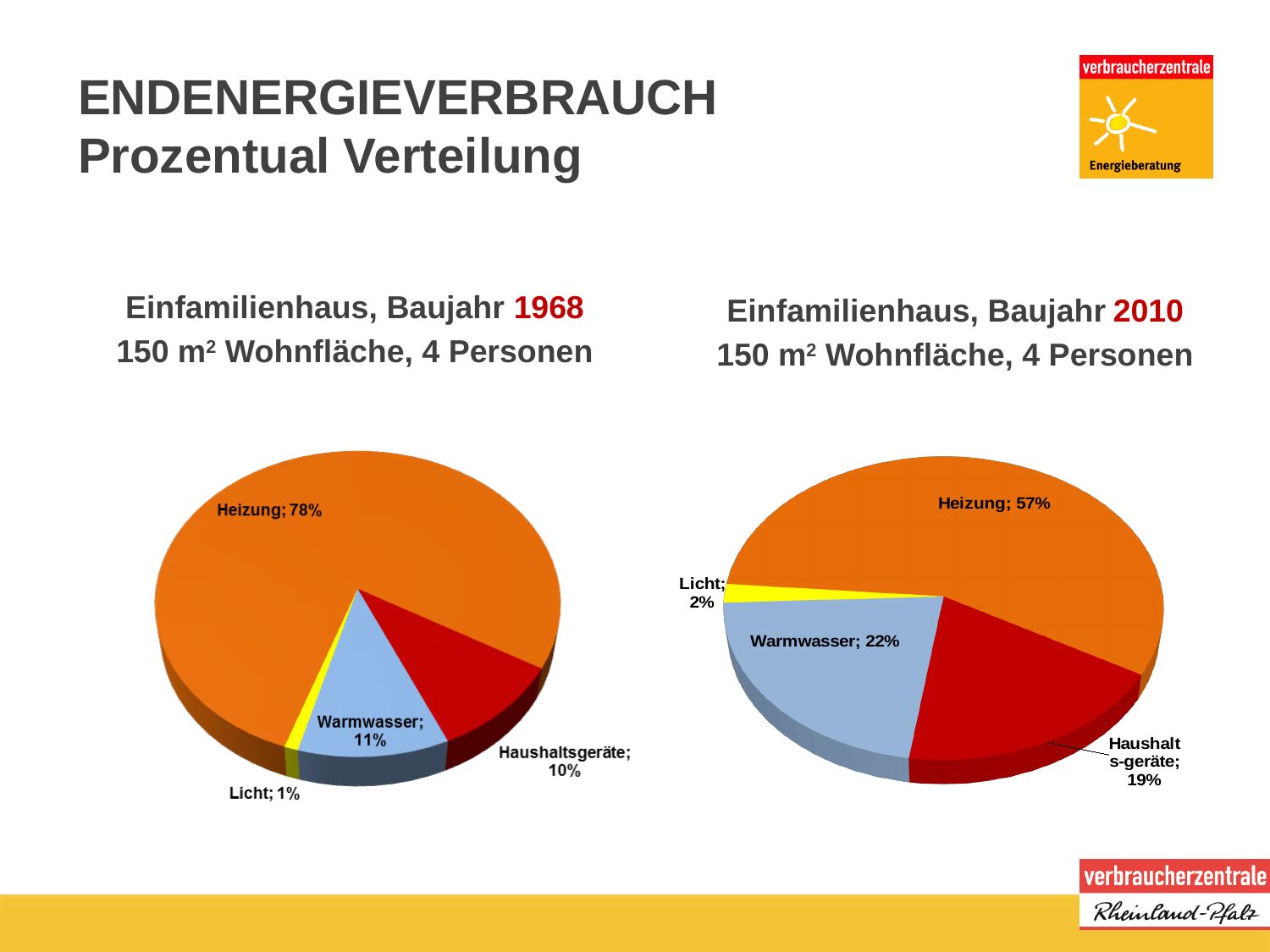
In the pie chart for Einfamilienhaus, Baujahr 2010, what is the combined share of Warmwasser and Haushaltsgeräte? 41% What type of chart is used for Einfamilienhaus, Baujahr 1968? Pie chart In the pie chart for Einfamilienhaus, Baujahr 1968, which category has the largest share? Heizung How many slices does the pie chart for Einfamilienhaus, Baujahr 2010 have? 4 In the pie chart for Einfamilienhaus, Baujahr 2010, what share does Warmwasser have? 22% In the pie chart for Einfamilienhaus, Baujahr 1968, which is larger: Warmwasser or Haushaltsgeräte? Warmwasser In the pie chart for Einfamilienhaus, Baujahr 1968, what share does Heizung have? 78% In the pie chart for Einfamilienhaus, Baujahr 2010, what share does Haushaltsgeräte have? 19% In the pie chart for Einfamilienhaus, Baujahr 2010, which category has the smallest share? Licht In the pie chart for Einfamilienhaus, Baujahr 1968, what colour is the Heizung slice? Orange In the pie chart for Einfamilienhaus, Baujahr 1968, what share does Licht have? 1% What is the difference between the Heizung share in the 1968 chart and the Heizung share in the 2010 chart? 21 percentage points